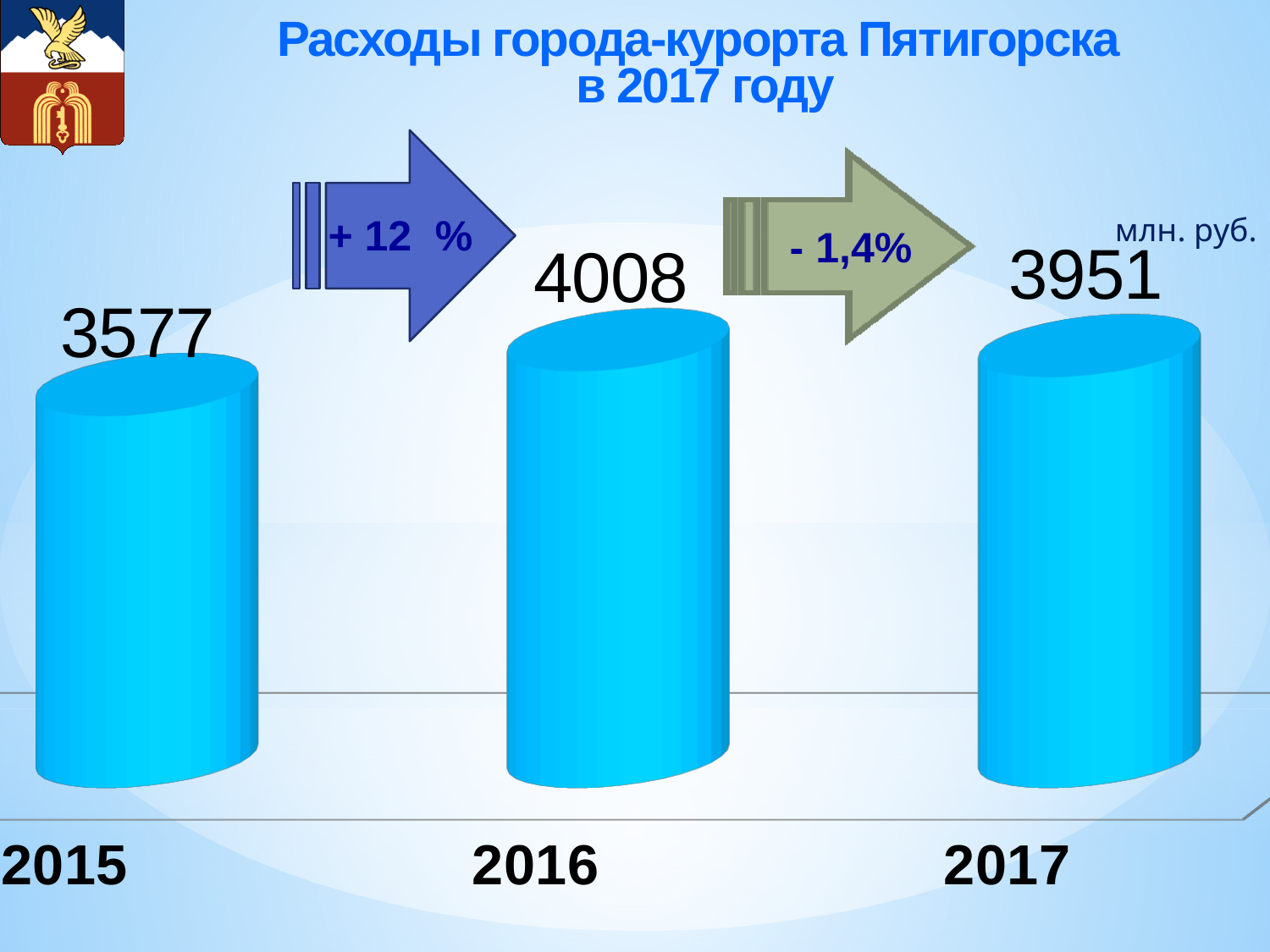
What unit is indicated for the values in the chart? млн. руб. What is the difference between the values for 2016 and 2015? 431 What is the value for 2017? 3951 What is the value for 2016? 4008 What is the difference between the values for 2016 and 2017? 57 Which is larger, the value for 2017 or the value for 2015? 2017 What kind of chart is this? bar chart What is the value for 2015? 3577 What percentage change is shown on the arrow between 2016 and 2017? - 1,4% Which year has the highest value? 2016 How many years are shown in the chart? 3 Which year has the lowest value? 2015